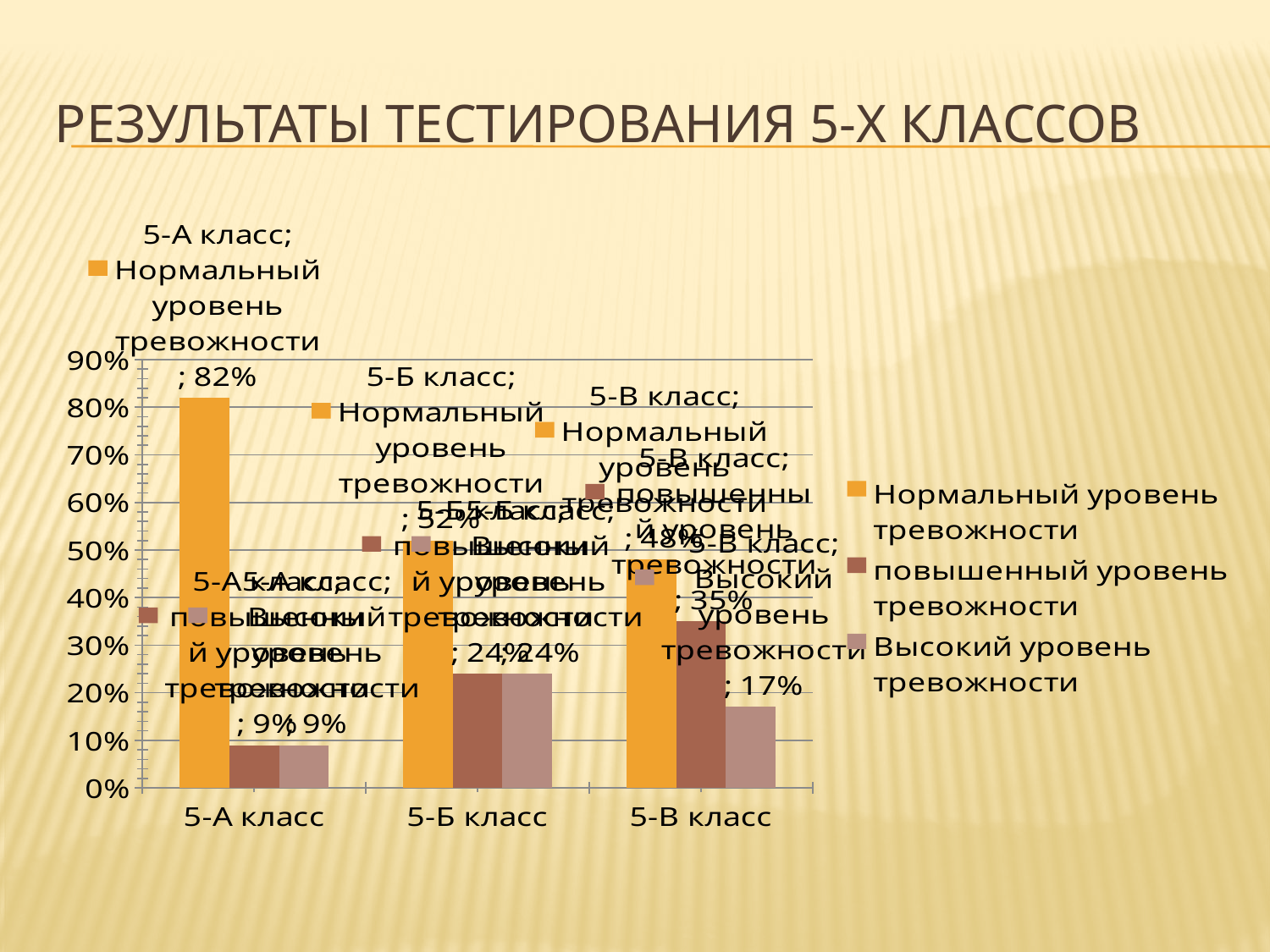
How many series does the legend list? 3 What is the value for Высокий уровень тревожности in 5-В класс? 17% What type of chart is shown on the slide? bar chart What is the value for Нормальный уровень тревожности in 5-Б класс? 52% What is the value for повышенный уровень тревожности in 5-В класс? 35% Which is larger: повышенный уровень тревожности in 5-Б класс or in 5-В класс? 5-В класс Does the value for Нормальный уровень тревожности fall or rise from 5-А класс to 5-В класс? fall What is the difference between the Нормальный уровень тревожности values for 5-А класс and 5-В класс? 34% How many classes (categories) are shown on the x axis? 3 Which class has the lowest value for Высокий уровень тревожности? 5-А класс Which class has the highest value for Нормальный уровень тревожности? 5-А класс What is the value for Нормальный уровень тревожности in 5-А класс? 82%